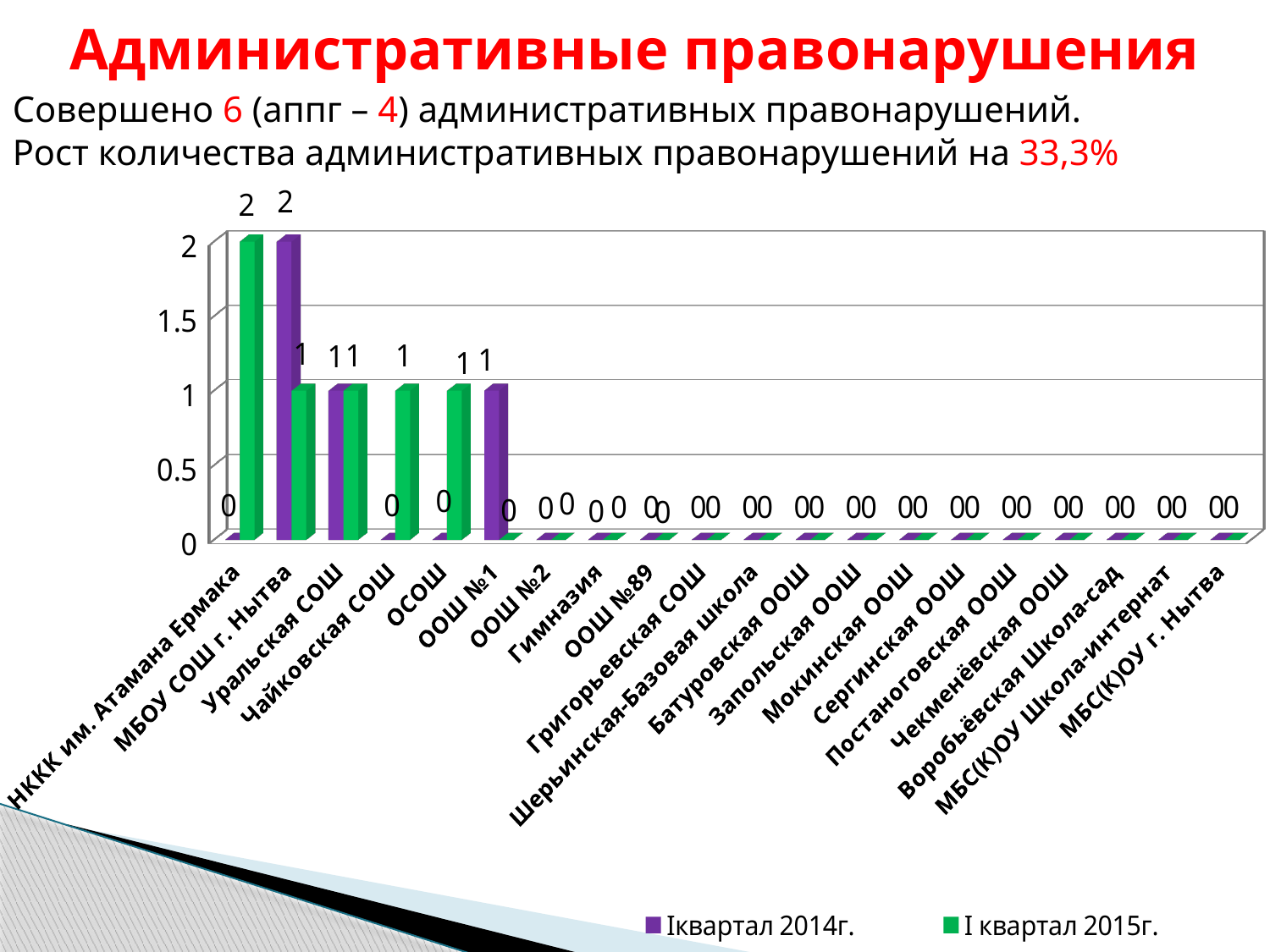
Which category has the highest value in the Iквартал 2014г. series? МБОУ СОШ г. Нытва What is the value for Гимназия in the I квартал 2015г. series? 0 What is the value for МБОУ СОШ г. Нытва in the Iквартал 2014г. series? 2 What is the difference between the I квартал 2015г. value and the Iквартал 2014г. value for НККК им. Атамана Ермака? 2 Which category has the highest value in the I квартал 2015г. series? НККК им. Атамана Ермака What type of chart is shown on the slide? bar chart For МБОУ СОШ г. Нытва, which series has the larger value, Iквартал 2014г. or I квартал 2015г.? Iквартал 2014г. What colour are the bars for the I квартал 2015г. series? green How many series does the legend list? 2 What is the value for НККК им. Атамана Ермака in the I квартал 2015г. series? 2 What is the value for Чайковская СОШ in the I квартал 2015г. series? 1 What is the value for ООШ №1 in the Iквартал 2014г. series? 1